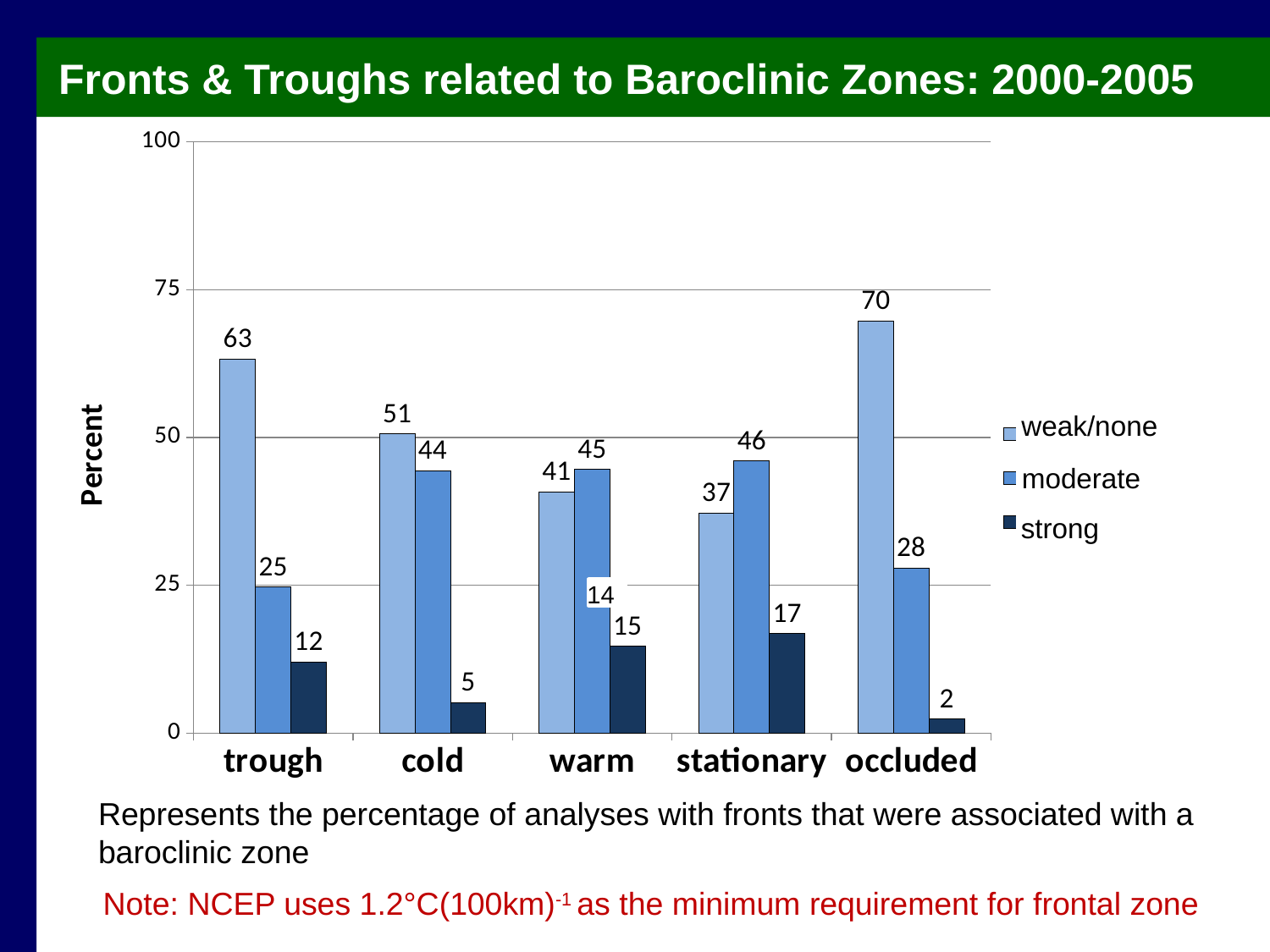
What type of chart is shown on the slide? bar chart How many categories are shown on the x axis? 5 What is the strong value for stationary? 17 Which category has the highest weak/none value? occluded What is the label on the y axis? Percent What is the moderate value for cold? 44 What is the weak/none value for occluded? 70 What is the difference between the weak/none and moderate values for trough? 38 Which category has the lowest strong value? occluded Is the weak/none value for cold greater or less than 50? greater For stationary, which is larger: the weak/none value or the moderate value? moderate How many series does the legend list? 3